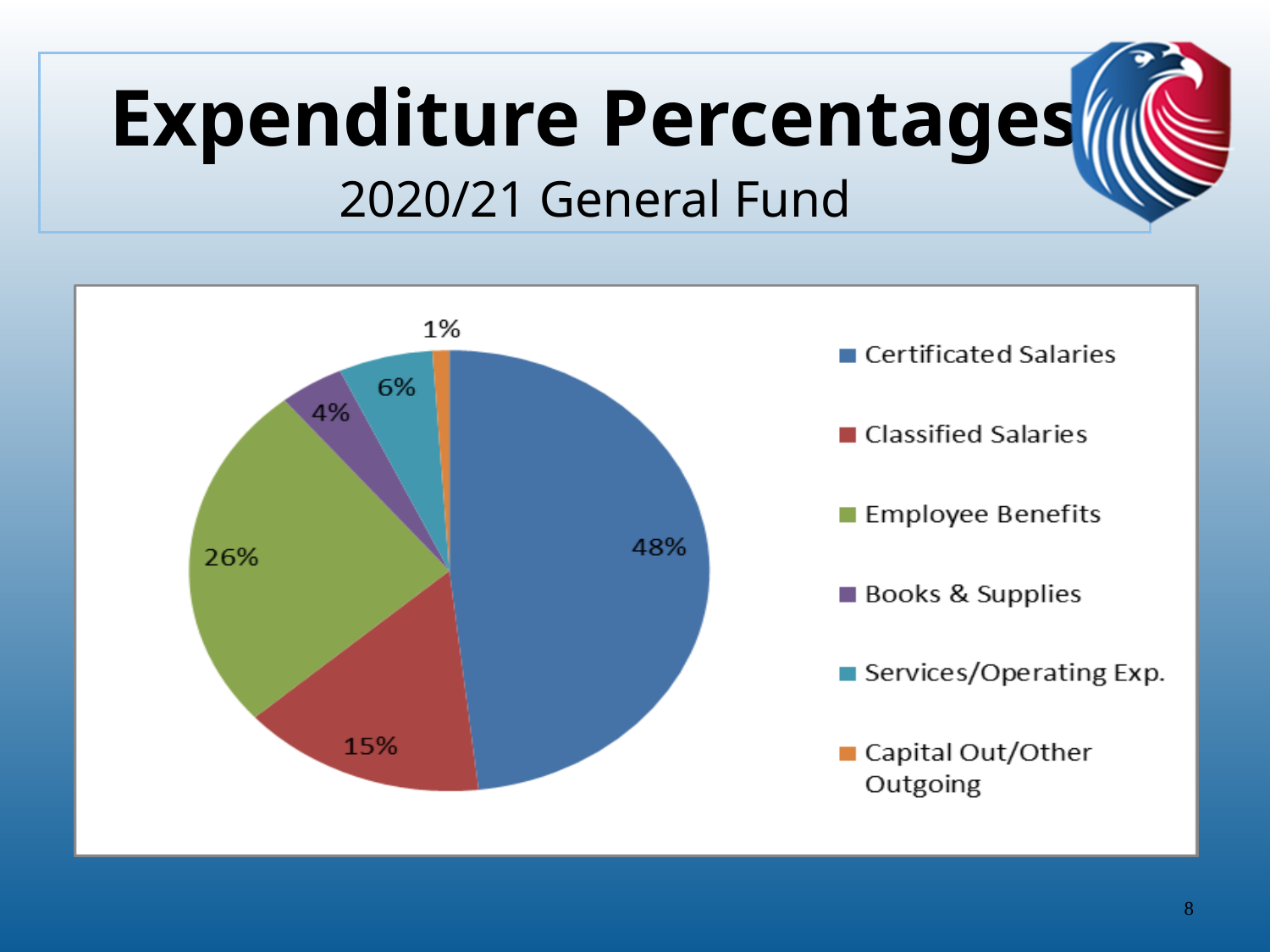
What is the difference in percentage points between Certificated Salaries and Employee Benefits? 22 How many categories does the pie chart show? 6 What percentage of expenditures is Classified Salaries? 15% What percentage of expenditures is Services/Operating Exp.? 6% What percentage of expenditures is Books & Supplies? 4% Which category has the largest share of the pie? Certificated Salaries What percentage of expenditures is Certificated Salaries? 48% Which is larger, Classified Salaries or Services/Operating Exp.? Classified Salaries Which category has the smallest share of the pie? Capital Out/Other Outgoing What kind of chart is shown on the slide? pie chart What percentage of expenditures is Employee Benefits? 26% What percentage of expenditures is Capital Out/Other Outgoing? 1%